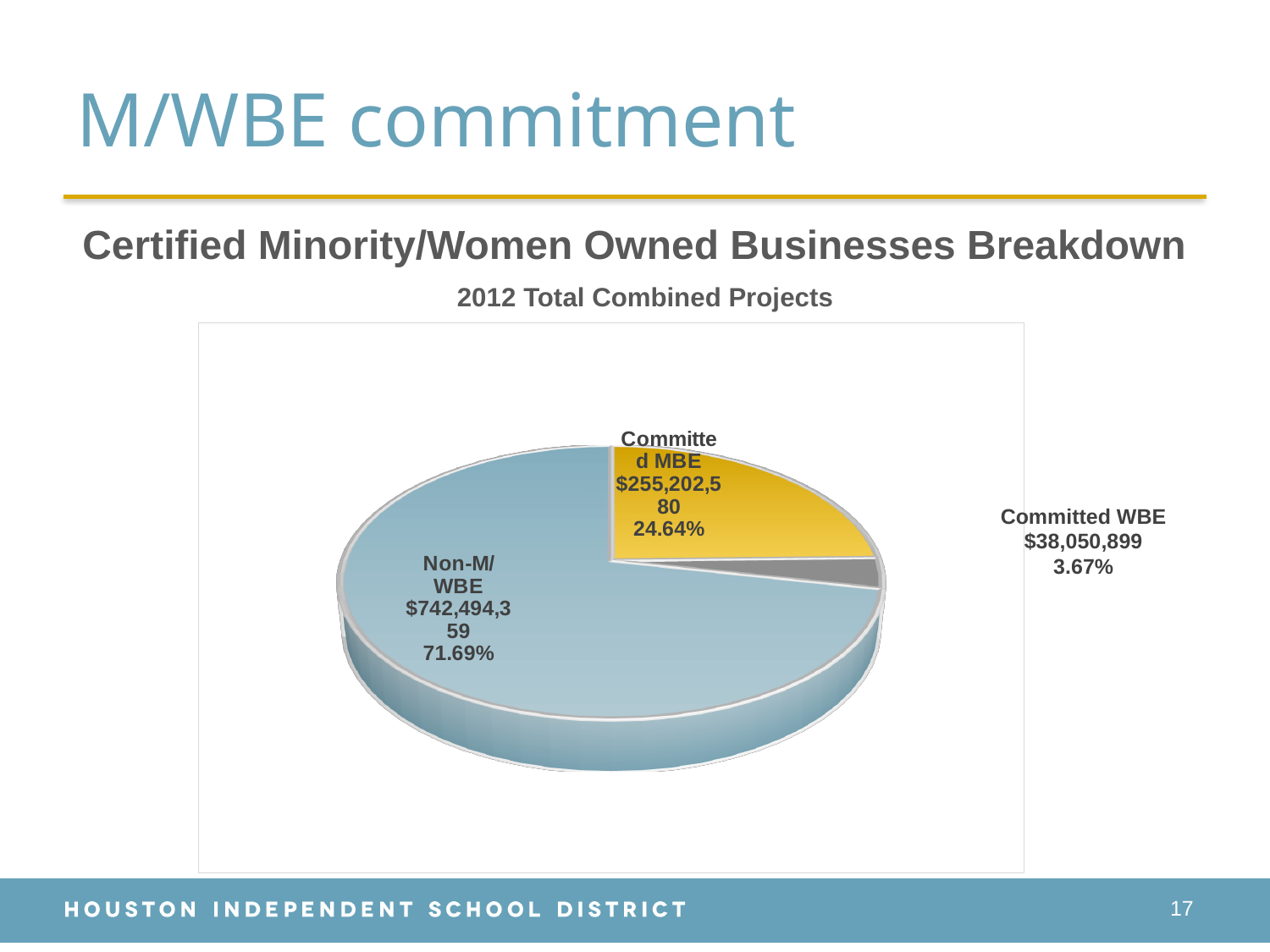
Which slice is the largest? Non-M/WBE What share of the pie does Non-M/WBE represent? 71.69% What is the dollar value for Committed MBE? $255,202,580 What is the title of the chart? 2012 Total Combined Projects What is the dollar value for Non-M/WBE? $742,494,359 What kind of chart is shown on the slide? pie chart What is the difference in percentage share between Non-M/WBE and Committed MBE? 47.05% Which is larger, Committed MBE or Committed WBE? Committed MBE How many slices does the pie chart have? 3 What share of the pie does Committed WBE represent? 3.67% Which slice is the smallest? Committed WBE What is the dollar value for Committed WBE? $38,050,899